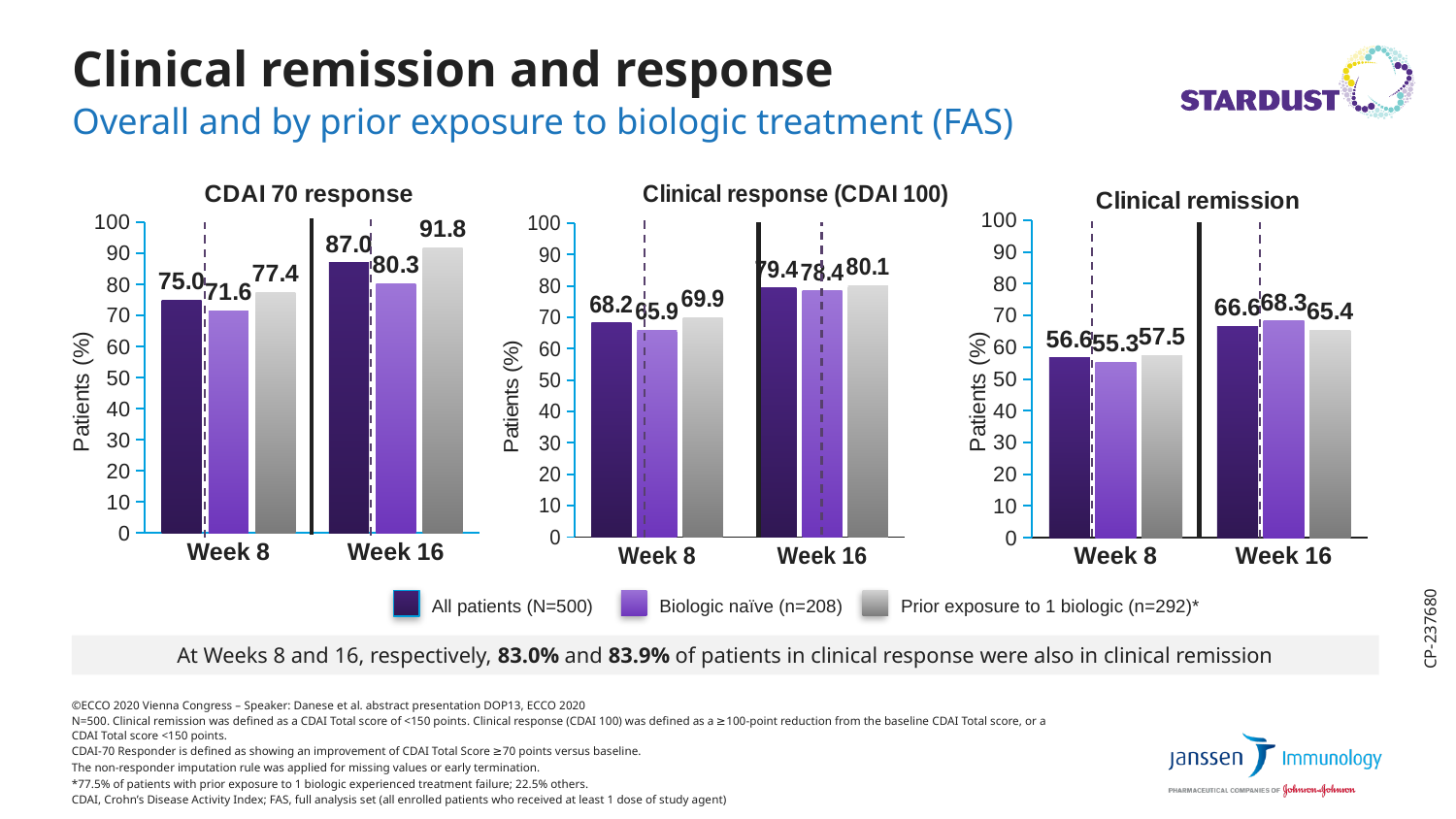
How many series does the legend list? 3 In the CDAI 70 response chart, which group has the highest value at Week 16? Prior exposure to 1 biologic (n=292) In the Clinical remission chart, which group has the lowest value at Week 8? Biologic naïve (n=208) In the Clinical response (CDAI 100) chart, is the value for All patients at Week 8 greater or less than 60? greater In the Clinical response (CDAI 100) chart, do the values for All patients rise or fall from Week 8 to Week 16? Rise What kind of chart is the Clinical remission chart? Bar chart In the CDAI 70 response chart, what is the value for All patients at Week 16? 87.0 In the CDAI 70 response chart, what is the difference between the Week 16 and Week 8 values for All patients? 12.0 In the Clinical response (CDAI 100) chart, what is the value for Biologic naïve patients at Week 8? 65.9 In the Clinical remission chart, what is the value for patients with prior exposure to 1 biologic at Week 16? 65.4 In the Clinical remission chart, which is larger at Week 16: the value for All patients or for Biologic naïve patients? Biologic naïve What is the title of the middle chart on the slide? Clinical response (CDAI 100)